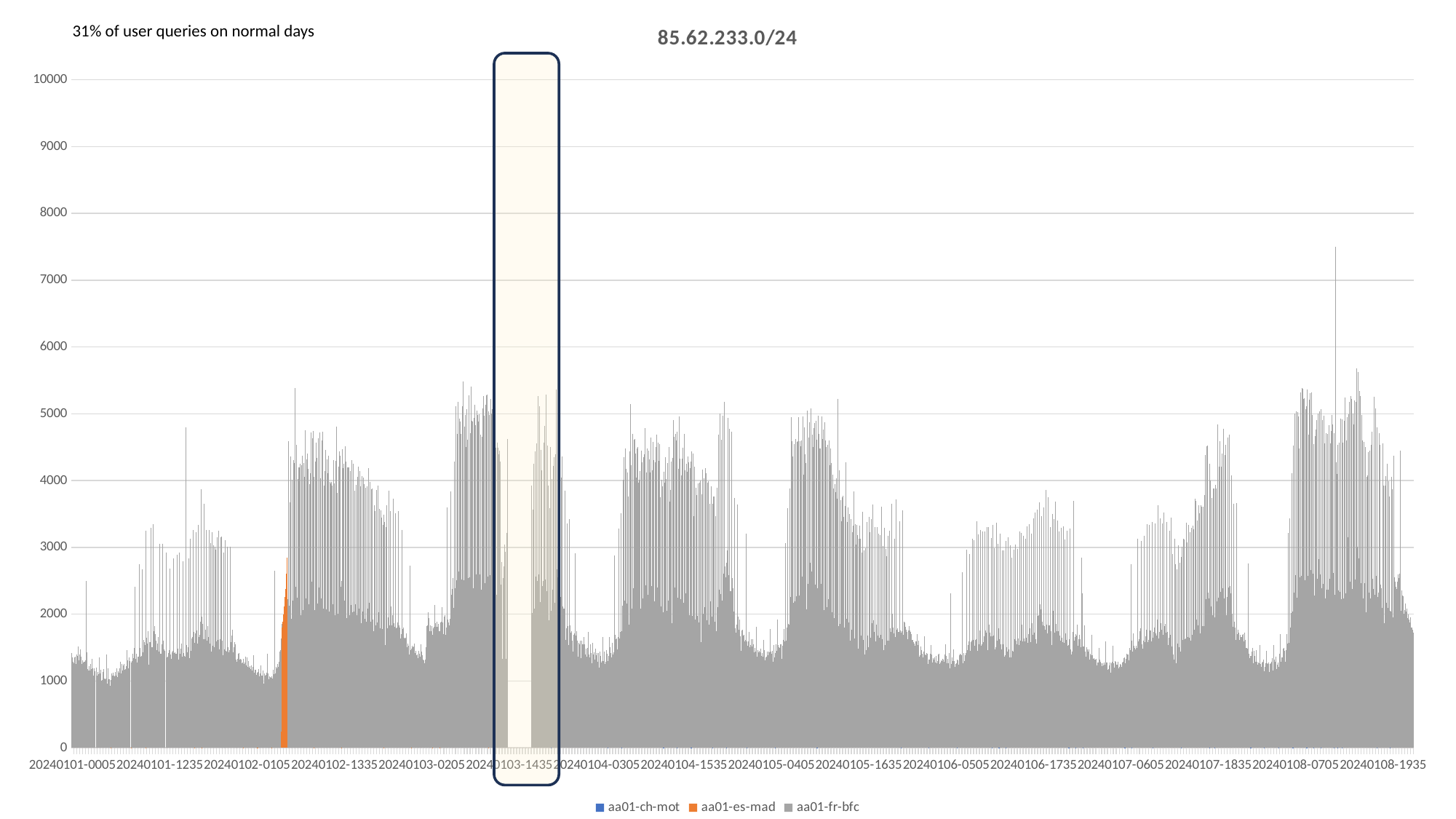
Is the value at 20240101-0005 larger or smaller than the peak near 20240108-0705? smaller Is the value at the last x-axis label, 20240108-1935, greater or less than 3000? less Which series is shown in orange in the legend? aa01-es-mad Is the value at the first x-axis label, 20240101-0005, greater or less than 2000? less What is the highest value shown on the vertical axis? 10000 Is the highest peak on the chart, near 20240108-0705, greater or less than 7000? greater What kind of chart is shown on the slide? bar chart What is the title of the chart? 85.62.233.0/24 Which series accounts for almost all of the plotted bars across the chart? aa01-fr-bfc How many series does the chart's legend list? 3